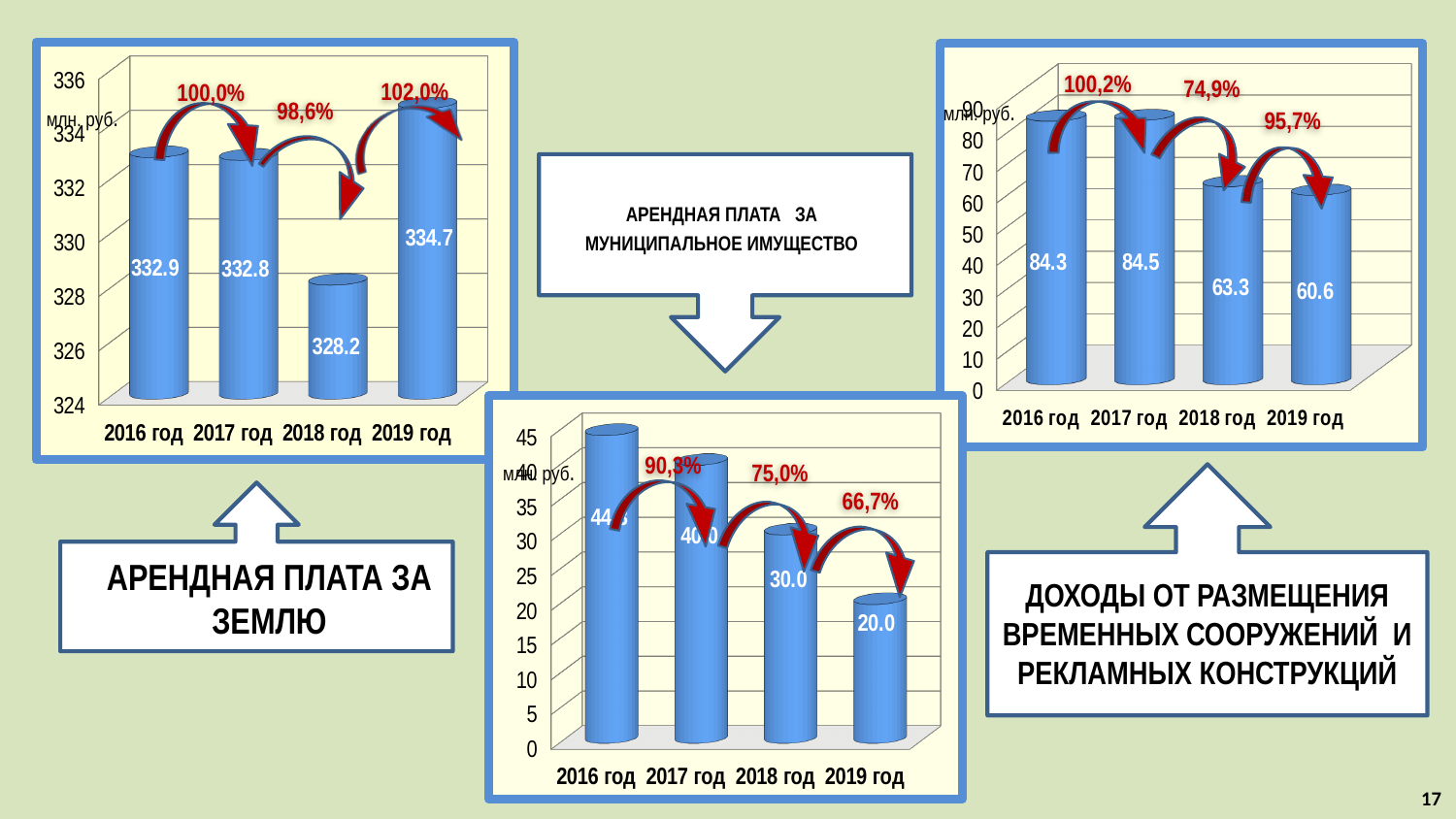
In the chart for 'Арендная плата за землю' (left), how many years are plotted? 4 In the chart for 'Доходы от размещения временных сооружений и рекламных конструкций' (right), which is larger, the value for 2017 год or 2018 год? 2017 год In the chart for 'Арендная плата за землю' (left), which year has the lowest value? 2018 год In the chart for 'Арендная плата за муниципальное имущество' (middle), what is the value for 2019 год? 20.0 In the chart for 'Арендная плата за муниципальное имущество' (middle), do the values rise or fall from 2016 год to 2019 год? fall In the chart for 'Арендная плата за землю' (left), what is the value for 2018 год? 328.2 In the chart for 'Арендная плата за землю' (left), which year has the highest value? 2019 год In the chart for 'Арендная плата за землю' (left), what is the difference between the 2019 год and 2018 год values? 6.5 In the chart for 'Арендная плата за муниципальное имущество' (middle), what is the difference between the 2018 год and 2019 год values? 10.0 In the chart for 'Доходы от размещения временных сооружений и рекламных конструкций' (right), is the value for 2019 год greater or less than 70? less In the chart for 'Доходы от размещения временных сооружений и рекламных конструкций' (right), what is the value for 2018 год? 63.3 What kind of chart is used for 'Арендная плата за землю' (left)? bar chart